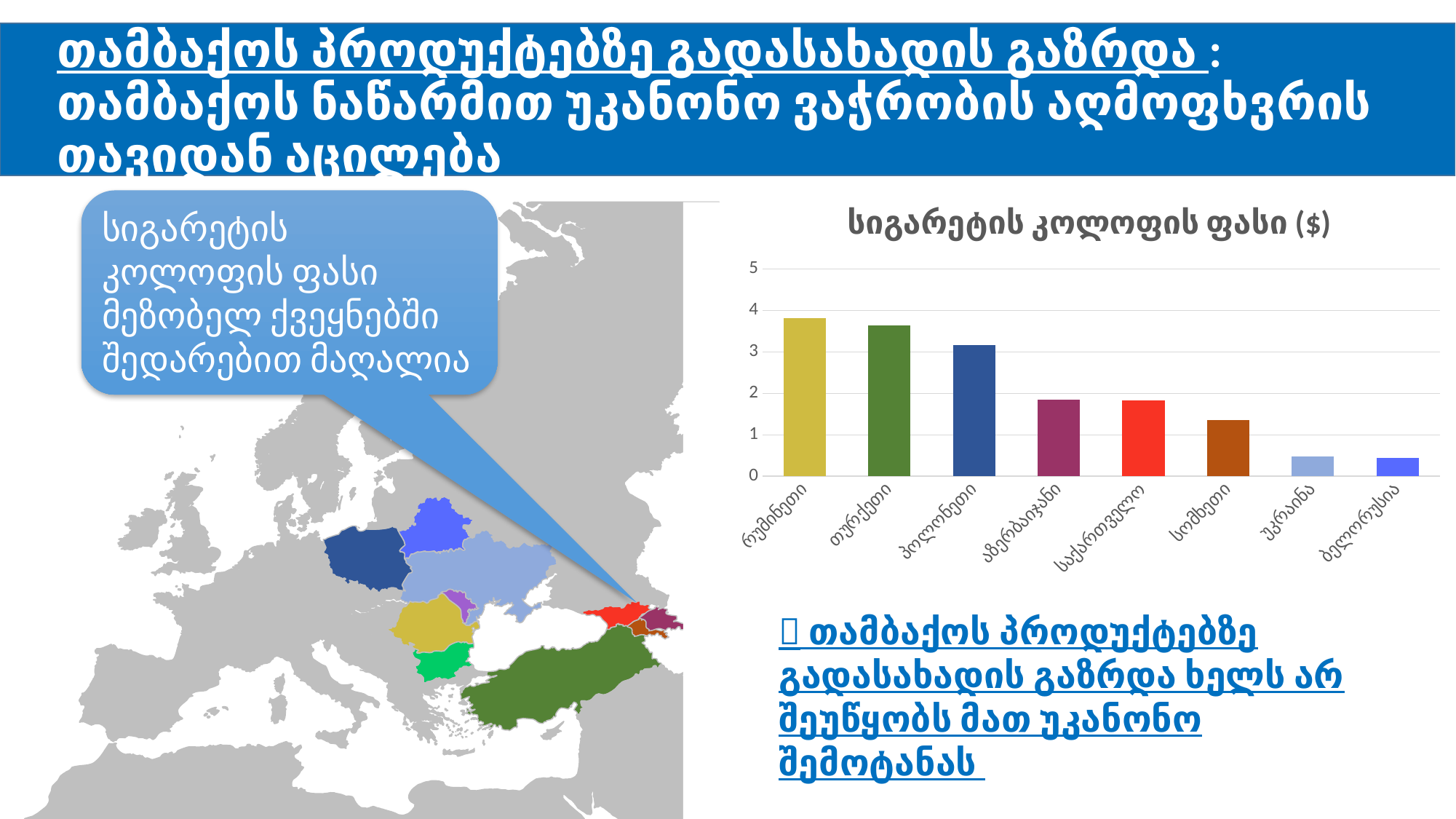
Is the value for აზერბაიჯანი greater or less than 2? less Is the value for უკრაინა greater or less than 1? less Which has a higher value, თურქეთი or საქართველო? თურქეთი What is the title of the chart? სიგარეტის კოლოფის ფასი ($) How many countries are shown on the chart? 8 Do the values rise or fall from left to right along the x axis? fall Which has a higher value, პოლონეთი or სომხეთი? პოლონეთი Is the value for რუმინეთი greater or less than 3? greater What kind of chart is shown on the slide? bar chart Which country has the highest cigarette pack price on the chart? რუმინეთი